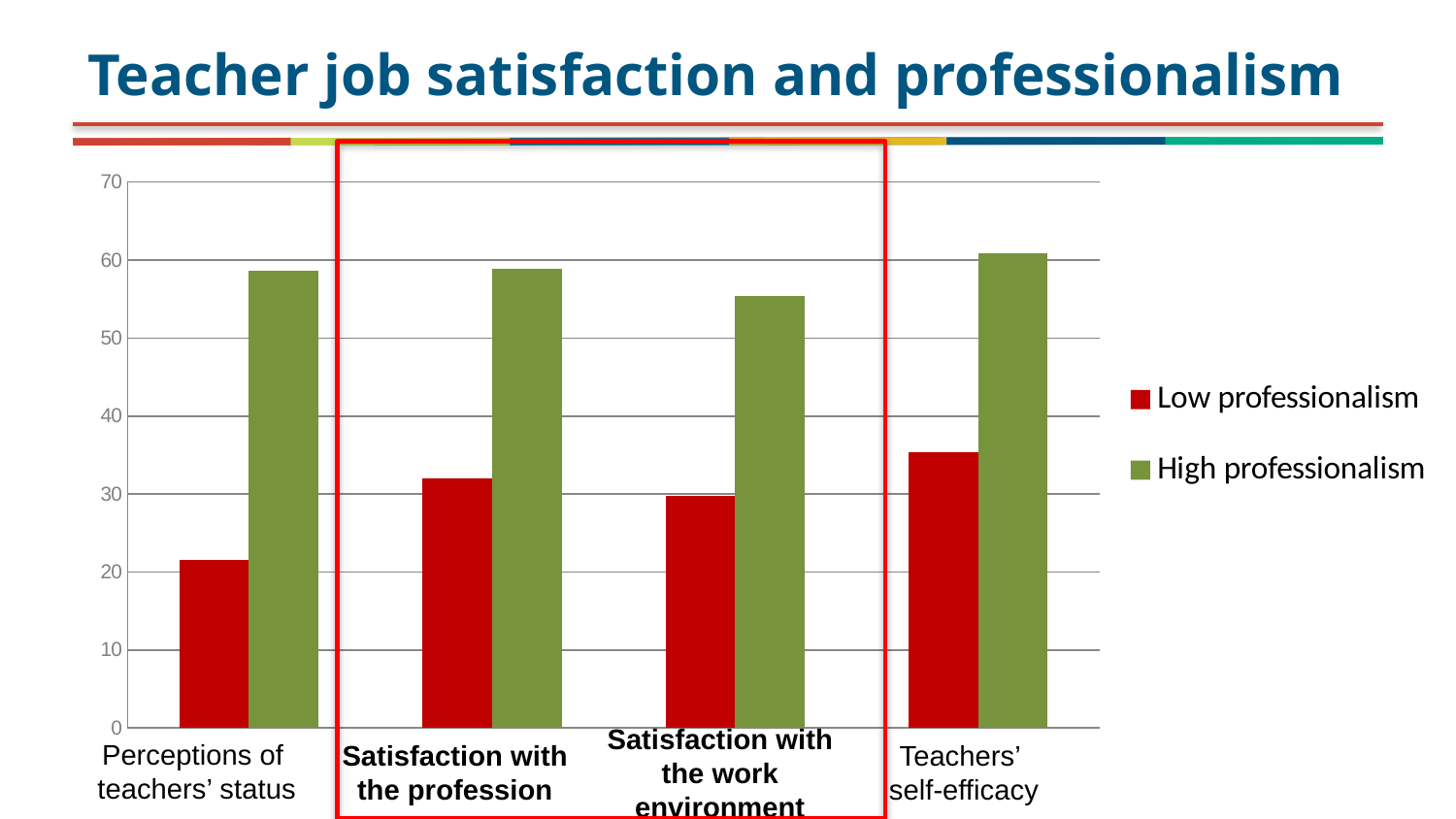
How many series does the legend list? 2 Which category has the highest value for Low professionalism? Teachers' self-efficacy How many categories are shown on the x axis? 4 Which category has the lowest value for Low professionalism? Perceptions of teachers' status Is the Low professionalism value for Perceptions of teachers' status greater or less than 30? less Is the Low professionalism value for Teachers' self-efficacy greater or less than 30? greater What is the title of the slide's chart? Teacher job satisfaction and professionalism What kind of chart is shown on the slide? Bar chart Which colour represents High professionalism in the legend? Green Which category has the lowest value for High professionalism? Satisfaction with the work environment Which is larger: the Low professionalism value for Satisfaction with the profession or for Satisfaction with the work environment? Satisfaction with the profession Is the High professionalism value for Satisfaction with the work environment greater or less than 50? greater